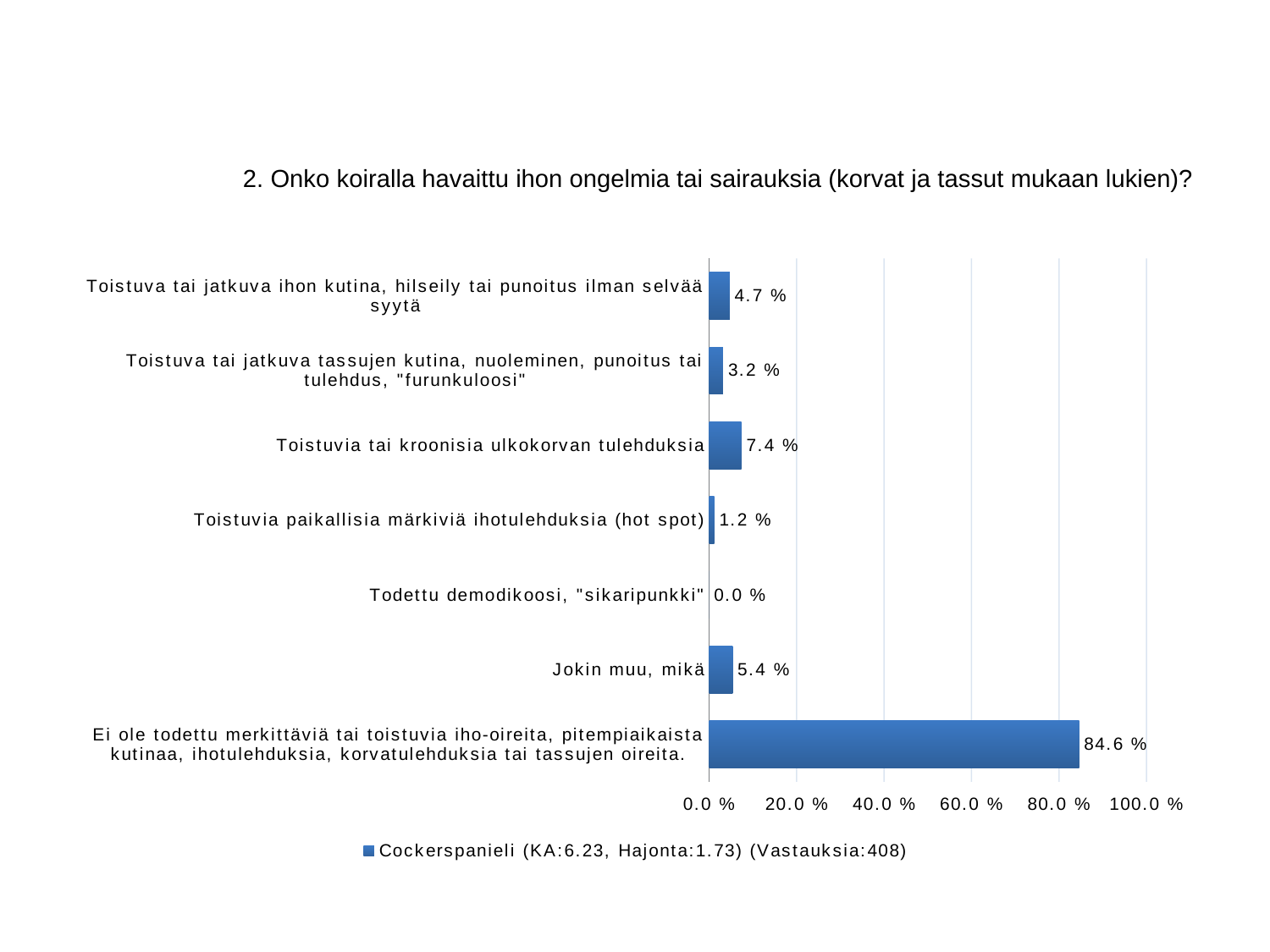
How many categories are shown in the chart? 7 Which is larger: the value for "Jokin muu, mikä" or the value for "Toistuva tai jatkuva tassujen kutina, nuoleminen, punoitus tai tulehdus, "furunkuloosi""? Jokin muu, mikä Is the value for "Ei ole todettu merkittäviä tai toistuvia iho-oireita..." greater or less than 80.0 %? greater How many series does the legend list? 1 Which category has the lowest value? Todettu demodikoosi, "sikaripunkki" What is the value for "Todettu demodikoosi, "sikaripunkki""? 0.0 % What is the difference between the values for "Toistuvia tai kroonisia ulkokorvan tulehduksia" and "Toistuvia paikallisia märkiviä ihotulehduksia (hot spot)"? 6.2 % Which category has the highest value? Ei ole todettu merkittäviä tai toistuvia iho-oireita, pitempiaikaista kutinaa, ihotulehduksia, korvatulehduksia tai tassujen oireita. What is the value for "Jokin muu, mikä"? 5.4 % What kind of chart is shown on the slide? bar chart What is the value for "Toistuvia tai kroonisia ulkokorvan tulehduksia"? 7.4 % How many responses (Vastauksia) does the legend entry report? 408